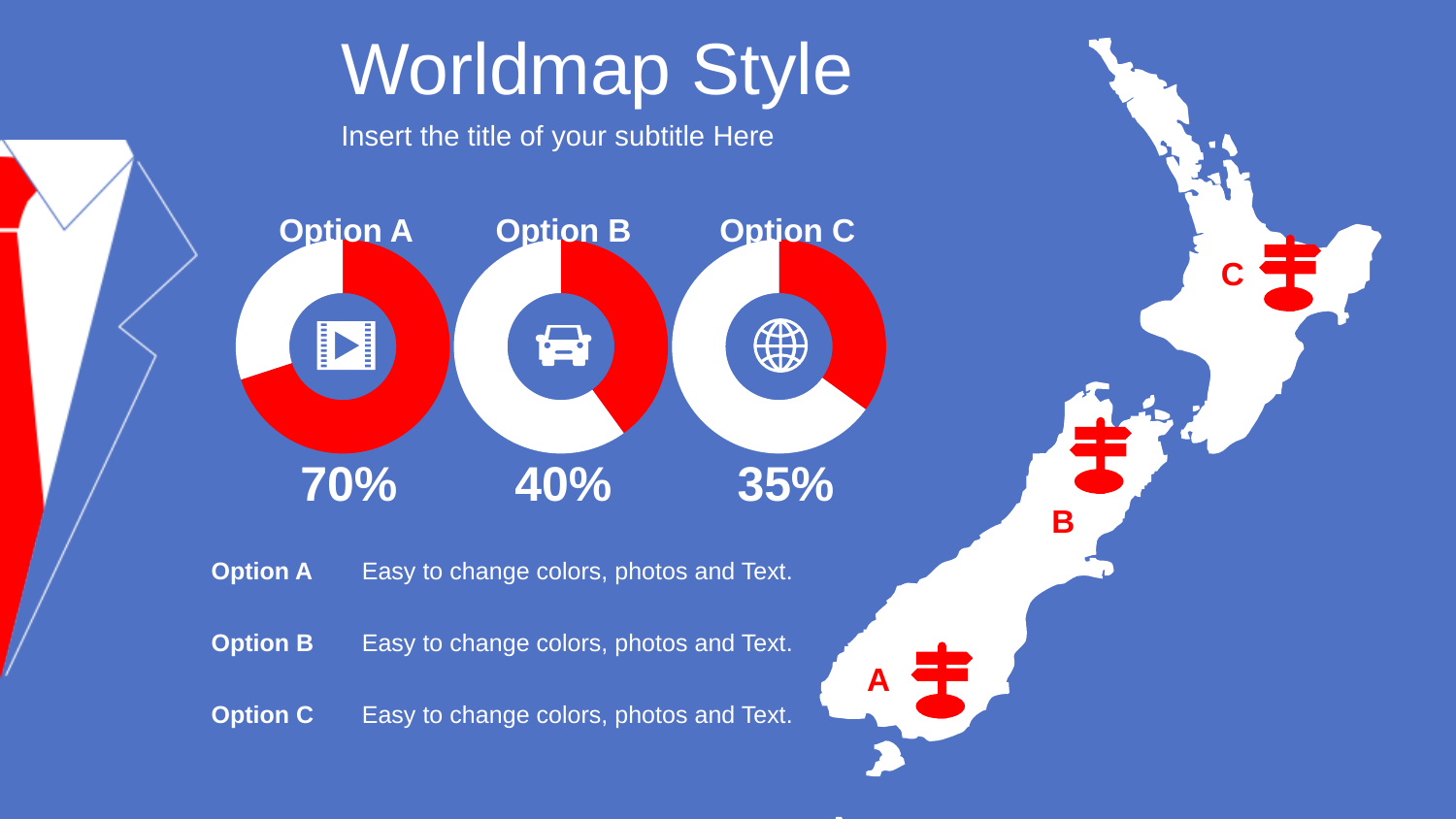
What is the difference between the percentages shown for Option A and Option B? 30% What percentage is shown below the Option B donut chart? 40% What percentage is shown below the Option C donut chart? 35% How many donut charts are shown on the slide? 3 Which of the three donut charts (Option A, B or C) shows the lowest percentage? Option C What kind of chart is used to display the Option A, B and C percentages? Donut chart What percentage is shown below the Option A donut chart? 70% Which shows a larger percentage, the Option A chart or the Option C chart? Option A What icon appears in the centre of the Option B donut chart? A car Which of the three donut charts (Option A, B or C) shows the highest percentage? Option A What is the difference between the percentages shown for Option B and Option C? 5% What colour is the filled (highlighted) portion of each donut chart? Red